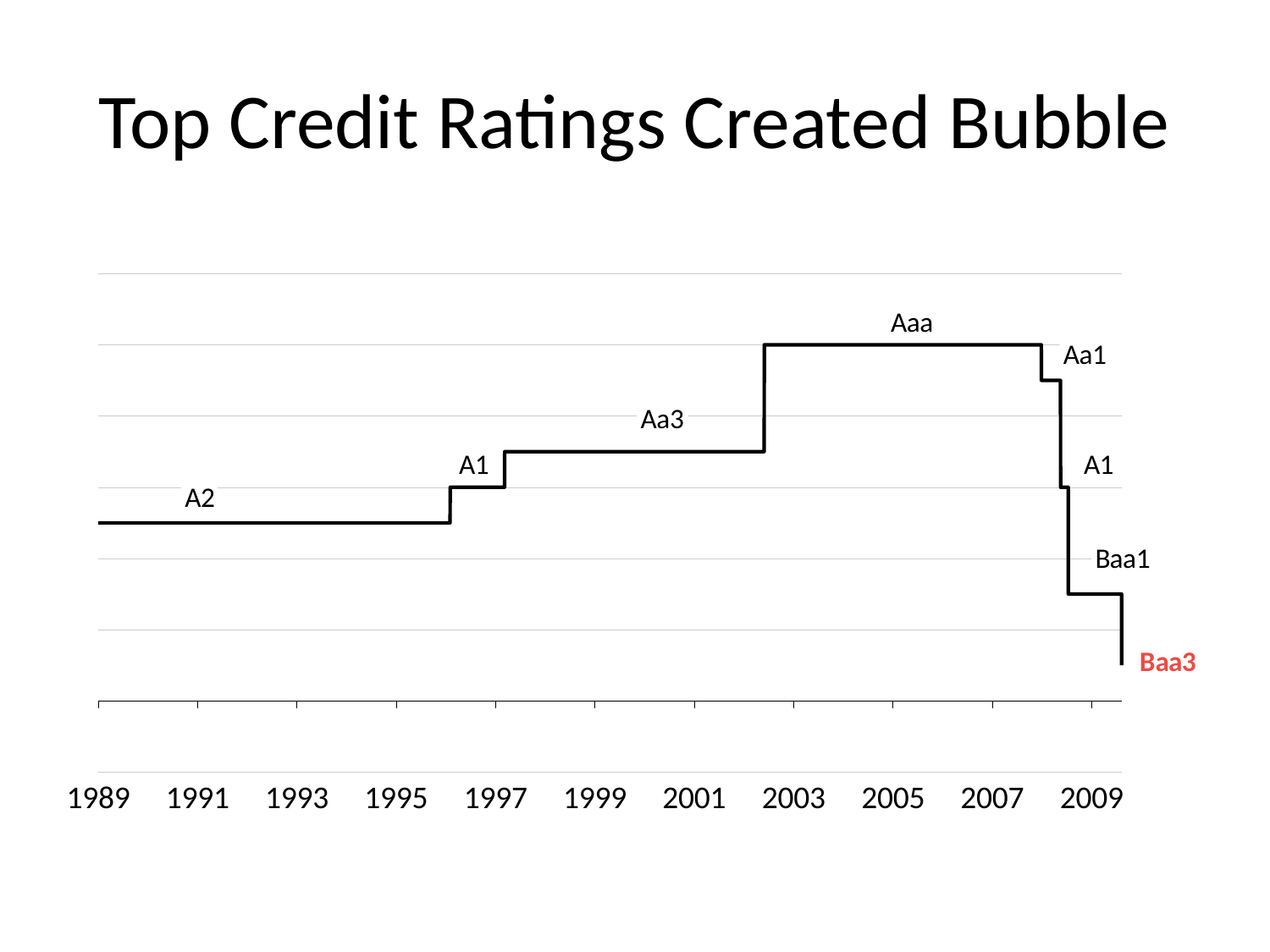
Does the line rise or fall after 2007? fall What is the first year shown on the x axis? 1989 Which credit rating label marks the highest point of the line? Aaa Which credit rating label marks the lowest point of the line? Baa3 What is the final credit rating shown at the right end of the line? Baa3 Does the line rise or fall between 1989 and 2005? rise What kind of chart is shown on the slide? line chart What credit rating is shown for 1999? Aa3 What is the title of the chart? Top Credit Ratings Created Bubble How many year labels are shown on the x axis? 11 What credit rating is shown for 2005? Aaa What credit rating is shown for 1989? A2